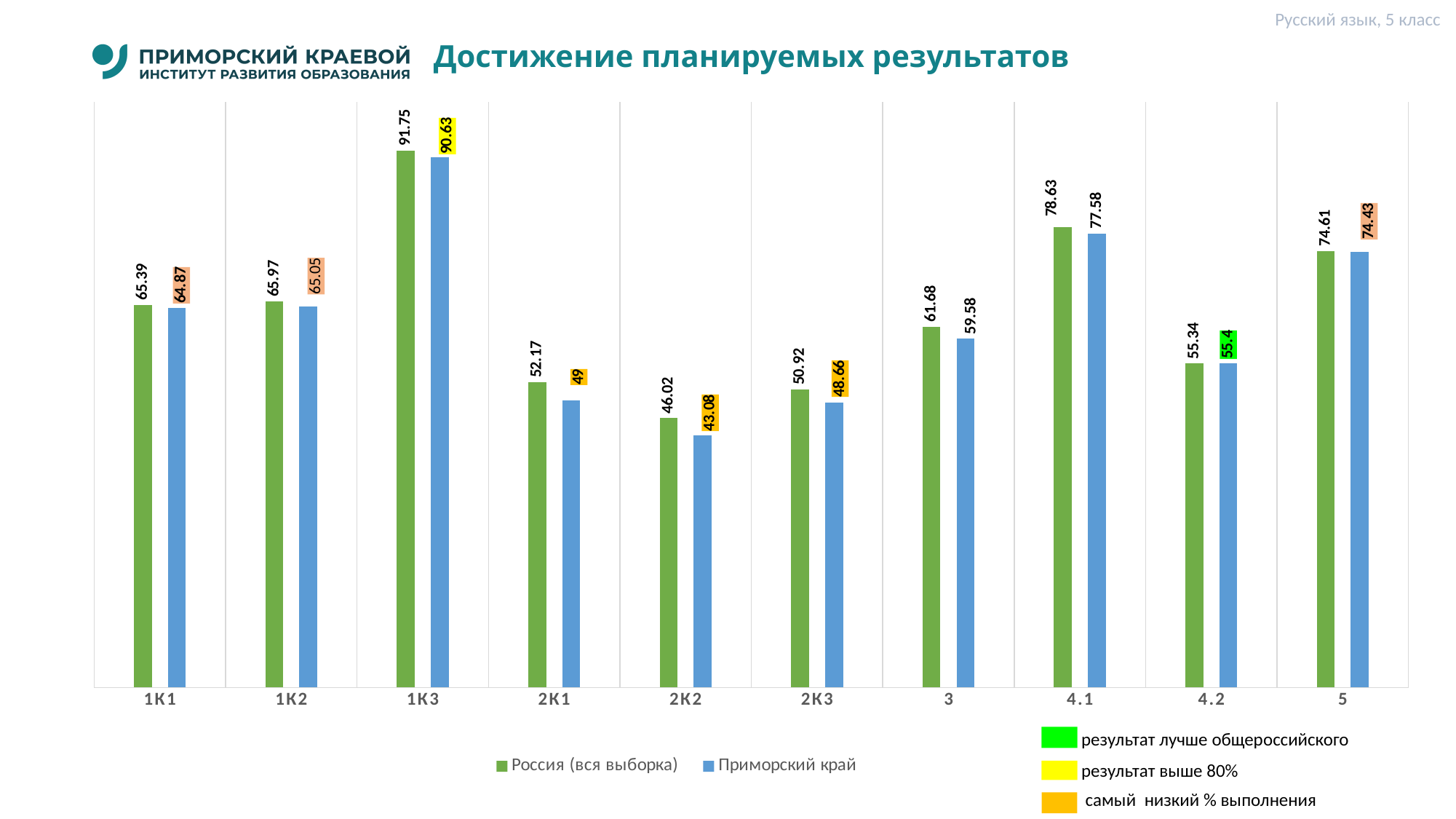
How many categories are shown on the x axis? 10 Which is larger in category 4.2: Россия (вся выборка) or Приморский край? Приморский край What is the value for Приморский край in category 5? 74.43 How many series does the legend list? 2 Which category has the highest value for Россия (вся выборка)? 1К3 What is the difference between Россия (вся выборка) and Приморский край in category 2К1? 3.17 What is the value for Россия (вся выборка) in category 2К2? 46.02 What is the title of the chart? Достижение планируемых результатов What is the value for Приморский край in category 1К3? 90.63 What kind of chart is shown on the slide? bar chart What is the value for Приморский край in category 4.2? 55.4 Which category has the lowest value for Приморский край? 2К2